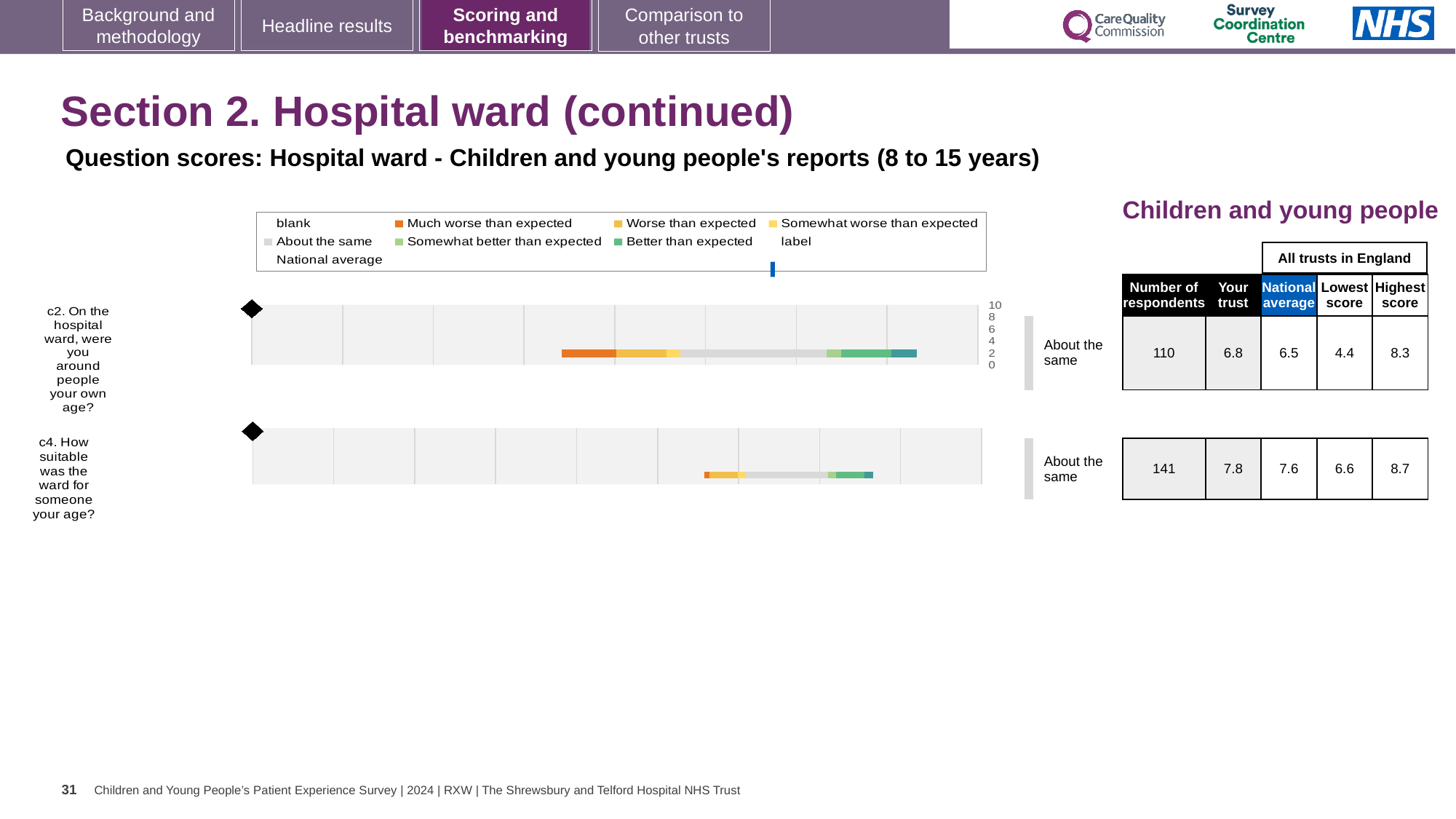
How many questions are plotted on the slide? 2 What is the lowest score among all trusts in England for question c2? 4.4 For question c2, is the 'Your trust' score higher or lower than the national average? higher What is the difference between the highest score and the lowest score for question c2? 3.9 For question c4 (How suitable was the ward for someone your age?), what is the 'Your trust' score? 7.8 What is the number of respondents for question c4? 141 For question c2 (On the hospital ward, were you around people your own age?), what is the 'Your trust' score? 6.8 What is the national average score for question c2? 6.5 What is the highest score among all trusts in England for question c4? 8.7 Which question has the higher 'Your trust' score, c2 or c4? c4 What benchmark rating label is shown for question c4? About the same What kind of chart is used to show the question scores on this slide? bar chart